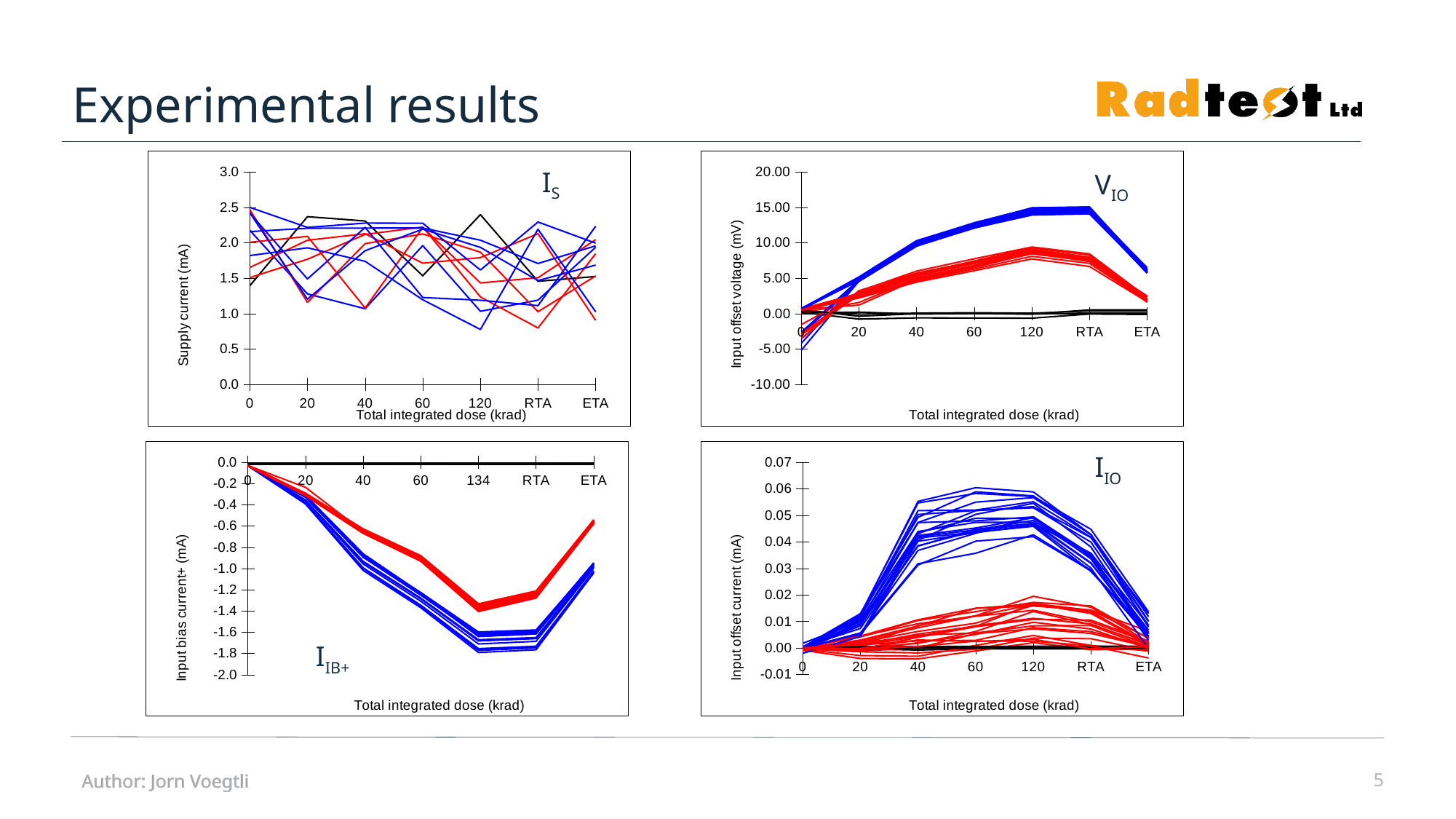
How many charts are shown on the slide? 4 In the V_IO chart, are the blue lines at RTA greater or less than 10.00? greater In the I_IO chart, are the blue lines at 60 greater or less than 0.03? greater In the I_IB+ chart, do the blue lines rise or fall between 0 and 134 krad? fall In the V_IO chart, are the red lines at 120 greater or less than 5.00? greater What is the y-axis label of the V_IO chart at the top right? Input offset voltage (mV) In the V_IO chart, at RTA, which is larger: the blue lines or the red lines? blue lines In the I_S chart, how many points are labelled on the x axis? 7 What kind of chart is the I_S chart at the top left? line chart What is the x-axis label shared by all four charts? Total integrated dose (krad) In the I_IB+ chart, at which x-axis point do the blue lines reach their lowest value? 134